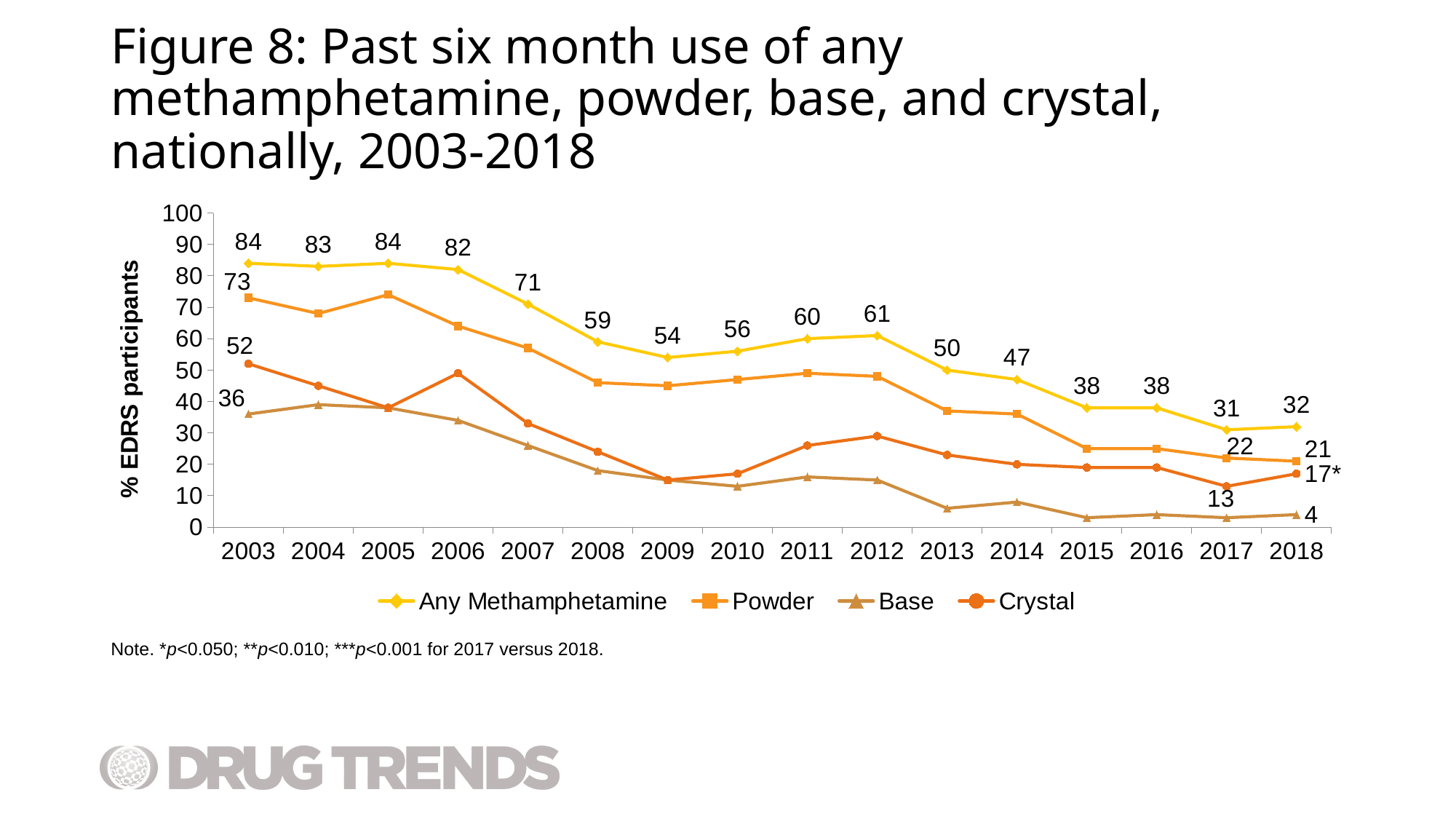
What is the value for Any Methamphetamine in 2003? 84 What kind of chart is shown on the slide? line chart What is the value for Powder in 2018? 21 How many series does the legend list? 4 Is the value for Base in 2013 greater or less than 10? less In which year is the Any Methamphetamine series at its lowest? 2017 How many years are shown on the x axis? 16 What is the difference between the Any Methamphetamine values for 2003 and 2018? 52 Does the Any Methamphetamine series generally rise or fall from 2003 to 2018? fall What is the value for Crystal in 2017? 13 What is the value for Base in 2003? 36 In 2003, which is larger: the Powder value or the Crystal value? Powder